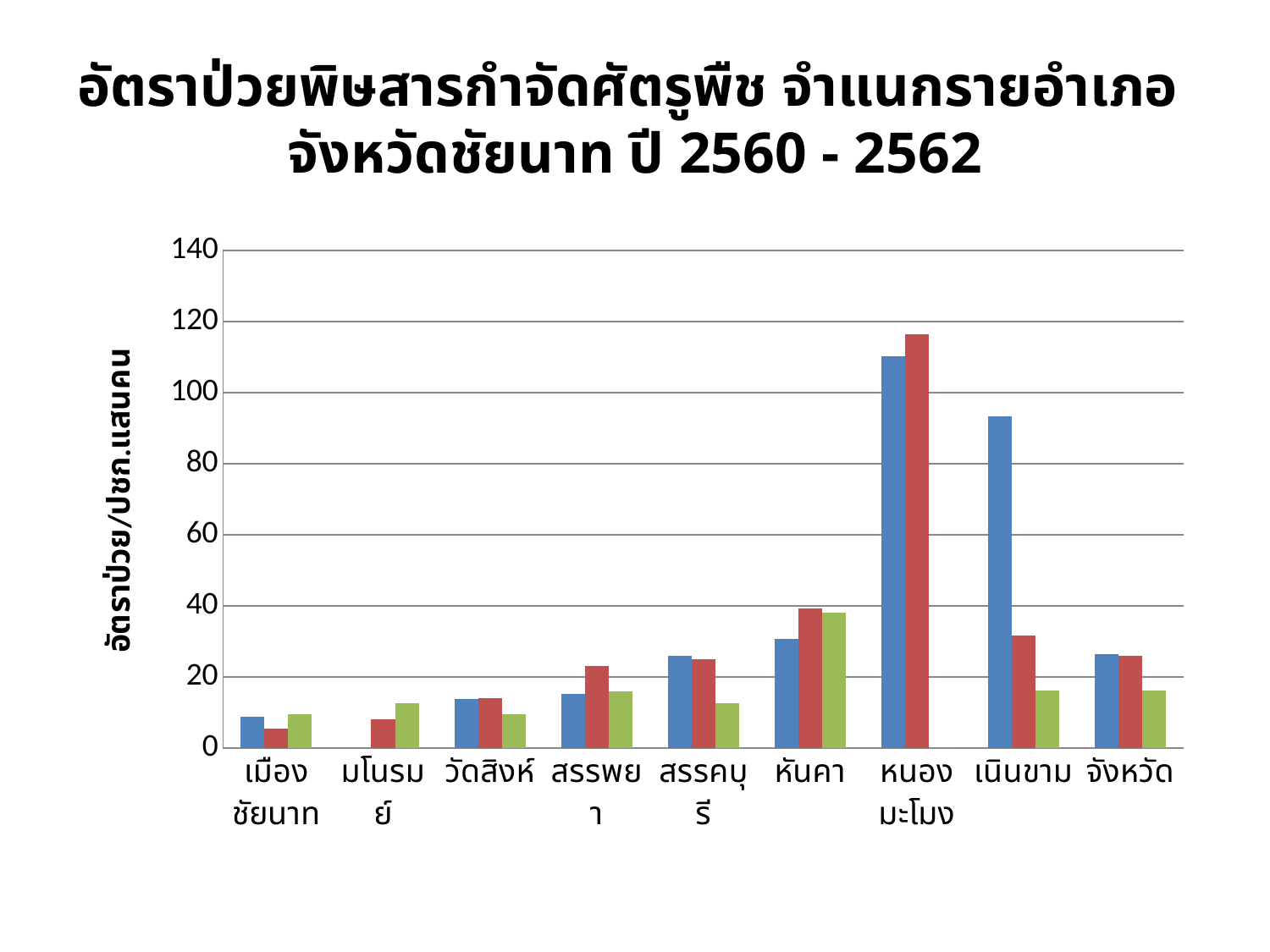
Which category has the tallest bar overall? หนองมะโมง Is the value of the red bar for หนองมะโมง greater or less than 100? greater Is the value of the blue bar for เนินขาม greater or less than 80? greater Is the value of the green bar for มโนรมย์ greater or less than 20? less For เนินขาม, which is larger: the blue bar or the red bar? the blue bar Which category has the tallest blue bar? หนองมะโมง For สรรพยา, which is larger: the blue bar or the red bar? the red bar How many categories are shown along the x axis? 9 What kind of chart is shown on the slide? bar chart What is the label on the vertical axis? อัตราป่วย/ปชก.แสนคน